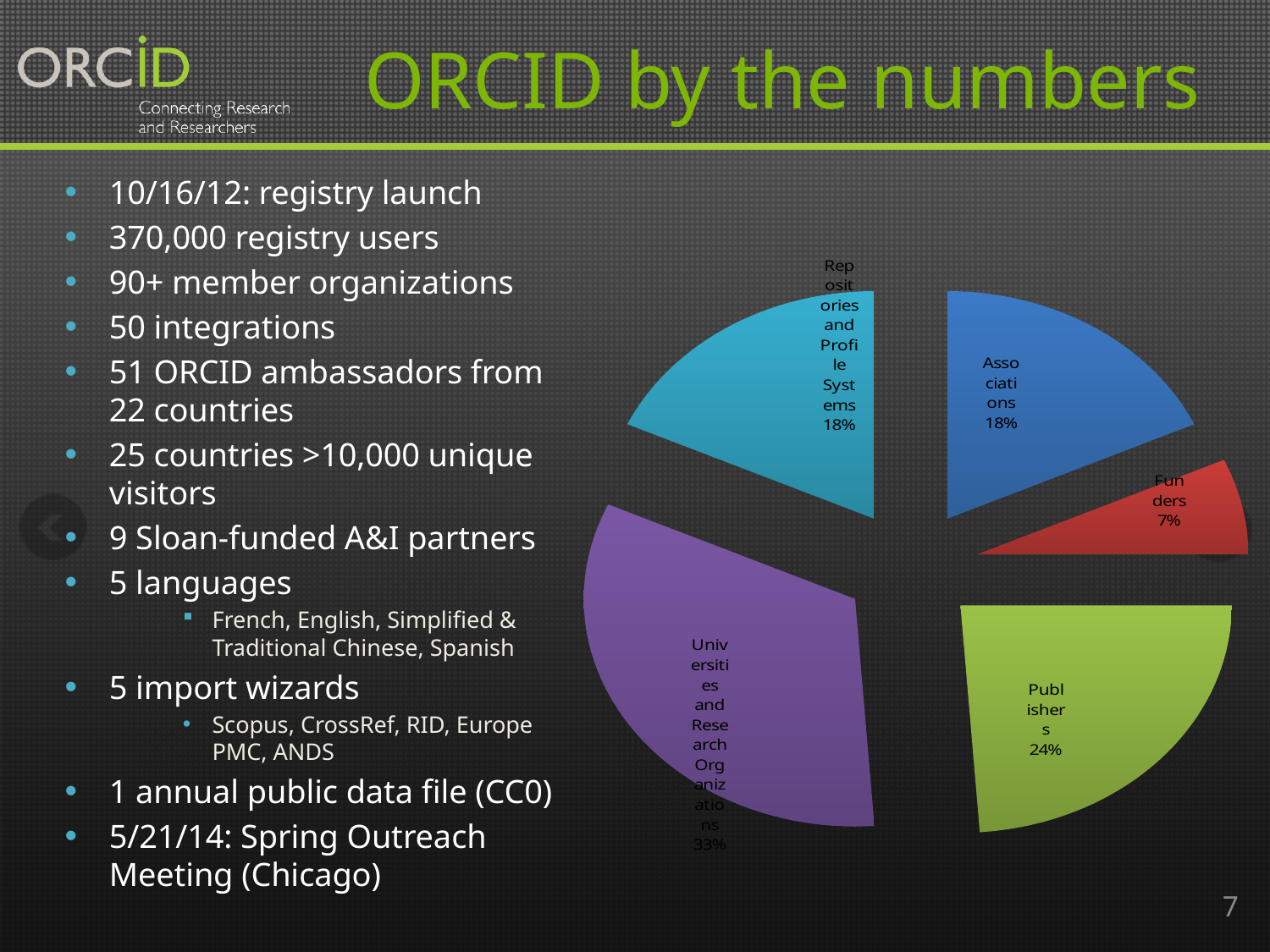
Which slice of the pie chart is the largest? Universities and Research Organizations How many slices does the pie chart have? 5 What is the difference in percentage points between the Universities and Research Organizations slice and the Publishers slice? 9 What colour is the Funders slice in the pie chart? red What share of the pie does the Universities and Research Organizations slice represent? 33% What share of the pie does the Funders slice represent? 7% What share of the pie does the Repositories and Profile Systems slice represent? 18% Which slice of the pie chart is the smallest? Funders What kind of chart is shown on the slide? pie chart Which is larger in the pie chart, Publishers or Associations? Publishers